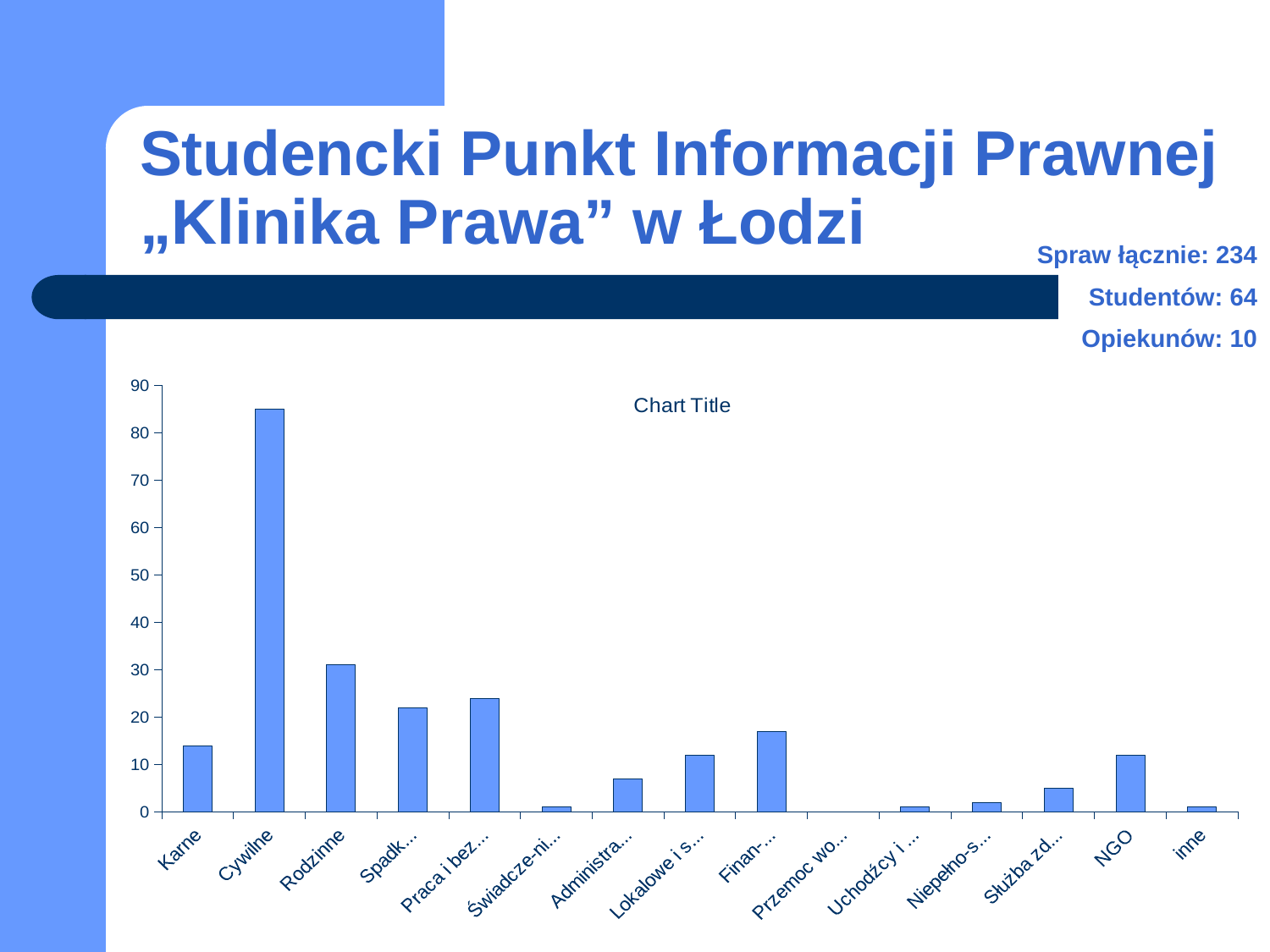
How many categories are plotted on the x axis of the chart? 15 Is the value for NGO greater or less than 20? less Is the value for Karne greater or less than 10? greater What kind of chart is shown on the slide? bar chart Which is larger, the value for Cywilne or the value for Rodzinne? Cywilne Is the value for Rodzinne greater or less than 20? greater Which category has the highest bar in the chart? Cywilne What is the title shown on the chart? Chart Title Which is larger, the value for Karne or the value for Administra...? Karne